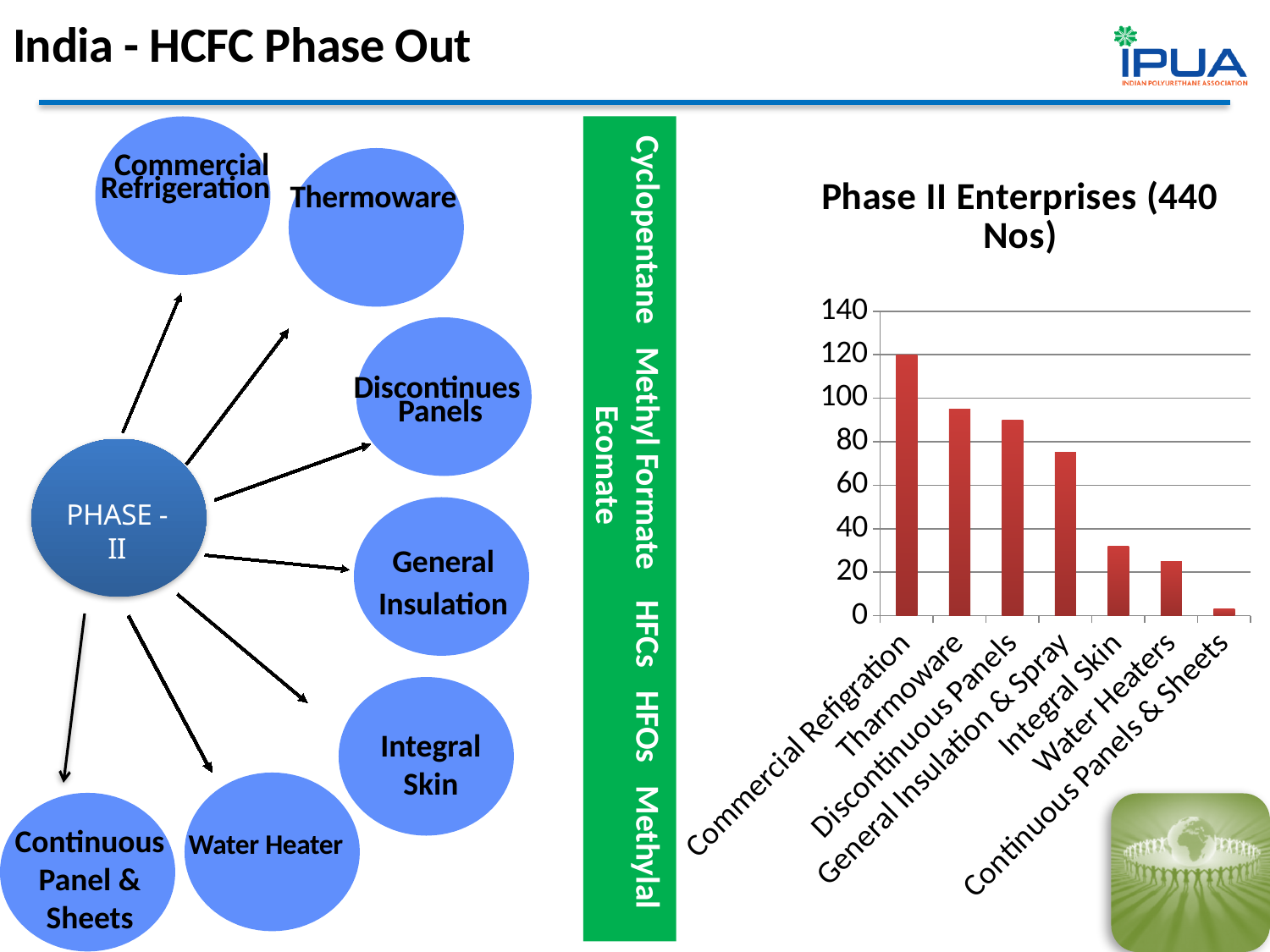
Do the values in the Phase II Enterprises chart rise or fall from left to right along the x axis? fall What kind of chart is shown on the slide? bar chart What is the title of the chart on the slide? Phase II Enterprises (440 Nos) Which category has the highest value in the Phase II Enterprises chart? Commercial Refigration What is the value for Commercial Refrigration in the Phase II Enterprises chart? 120 Which is larger in the Phase II Enterprises chart, Tharmoware or Water Heaters? Tharmoware Which category has the lowest value in the Phase II Enterprises chart? Continuous Panels & Sheets Is the value for Water Heaters greater or less than 20? greater Is the value for Tharmoware greater or less than 80? greater Is the value for General Insulation & Spray greater or less than 80? less How many categories are plotted in the Phase II Enterprises chart? 7